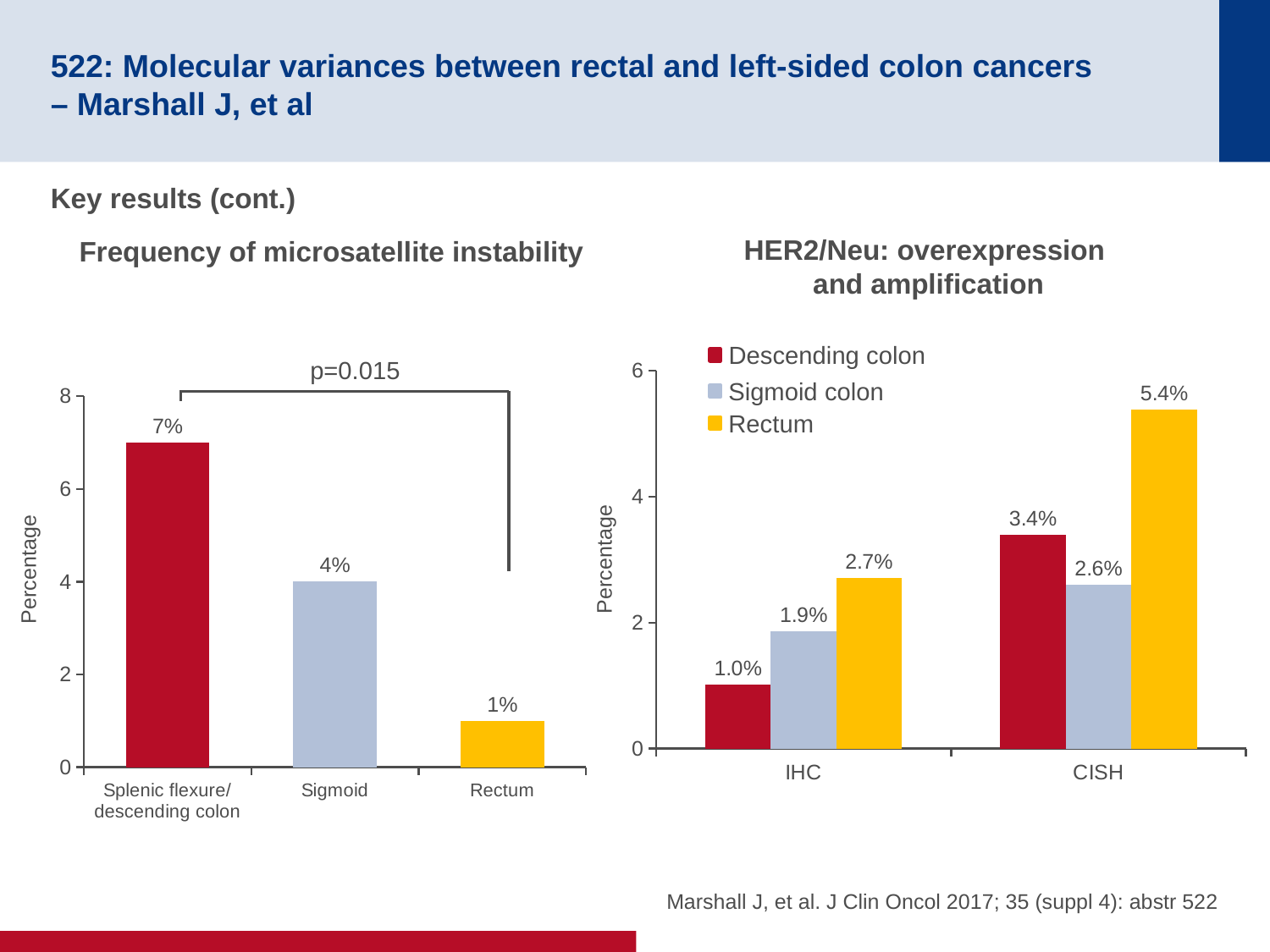
In the 'HER2/Neu: overexpression and amplification' chart, what is the difference between the Rectum values for CISH and IHC? 2.7% In the 'HER2/Neu: overexpression and amplification' chart, what is the value for Rectum under CISH? 5.4% In the 'HER2/Neu: overexpression and amplification' chart, which is larger under CISH: Descending colon or Sigmoid colon? Descending colon In the 'Frequency of microsatellite instability' chart, which category has the lowest value? Rectum In the 'Frequency of microsatellite instability' chart, what is the value for Sigmoid? 4% In the 'Frequency of microsatellite instability' chart, which category has the highest value? Splenic flexure/descending colon In the 'HER2/Neu: overexpression and amplification' chart, how many series does the legend list? 3 In the 'Frequency of microsatellite instability' chart, how many categories are shown on the x axis? 3 In the 'Frequency of microsatellite instability' chart, what is the difference between the Splenic flexure/descending colon value and the Rectum value? 6% What kind of chart is the 'HER2/Neu: overexpression and amplification' chart? Bar chart In the 'HER2/Neu: overexpression and amplification' chart, what is the value for Descending colon under IHC? 1.0% In the 'Frequency of microsatellite instability' chart, what p-value is shown? p=0.015